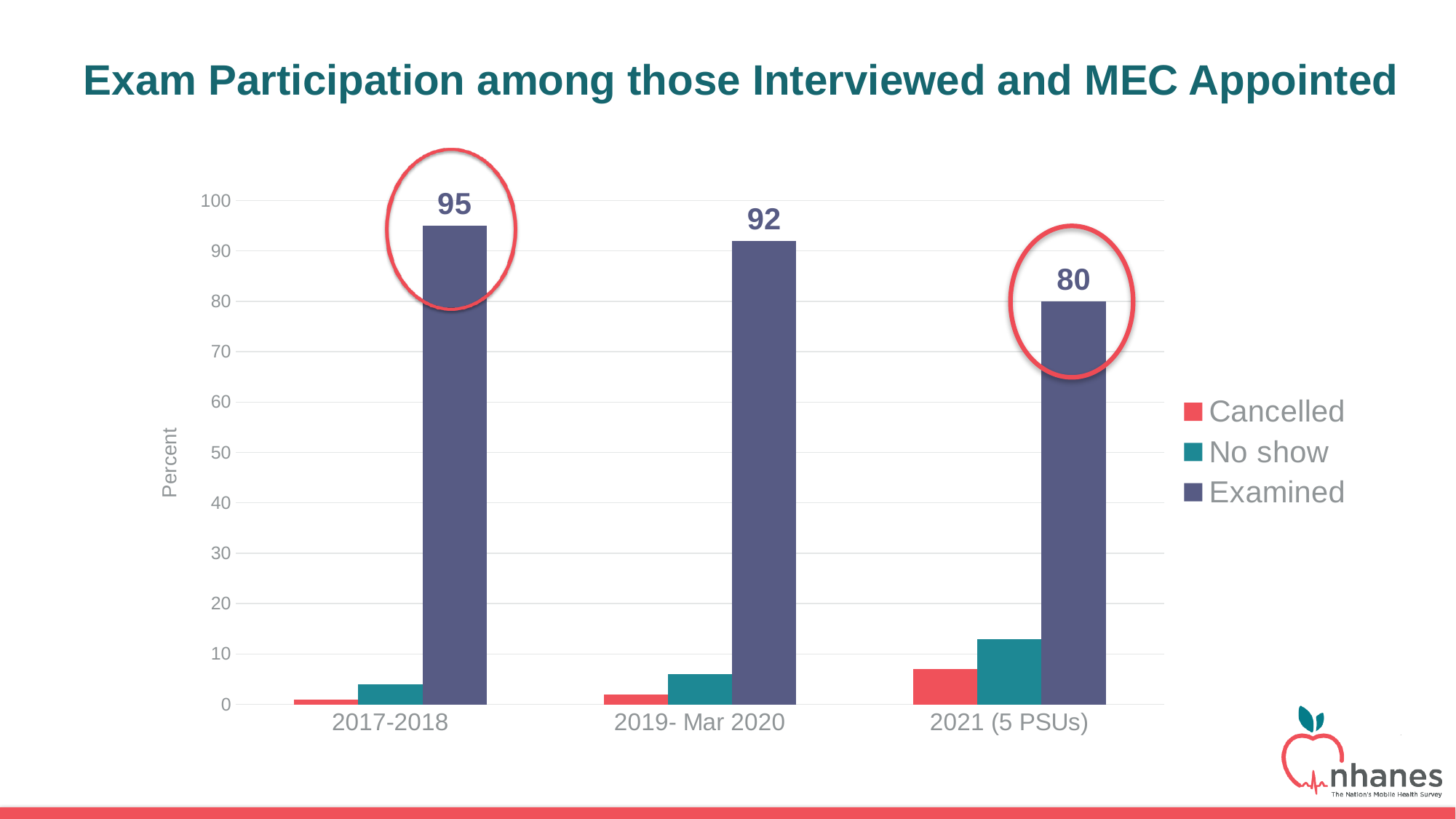
What kind of chart is shown on the slide? bar chart How many series does the legend list? 3 What is the Examined value for 2019- Mar 2020? 92 Is the No show value for 2021 (5 PSUs) greater or less than 10? greater What is the difference between the Examined values for 2017-2018 and 2021 (5 PSUs)? 15 Which period has the highest Examined value? 2017-2018 Is the Cancelled value for 2019- Mar 2020 greater or less than 10? less How many periods are shown on the x axis? 3 What is the Examined value for 2021 (5 PSUs)? 80 Which is larger, the Examined value for 2019- Mar 2020 or for 2021 (5 PSUs)? 2019- Mar 2020 Which period has the lowest Examined value? 2021 (5 PSUs) What is the Examined value for 2017-2018? 95